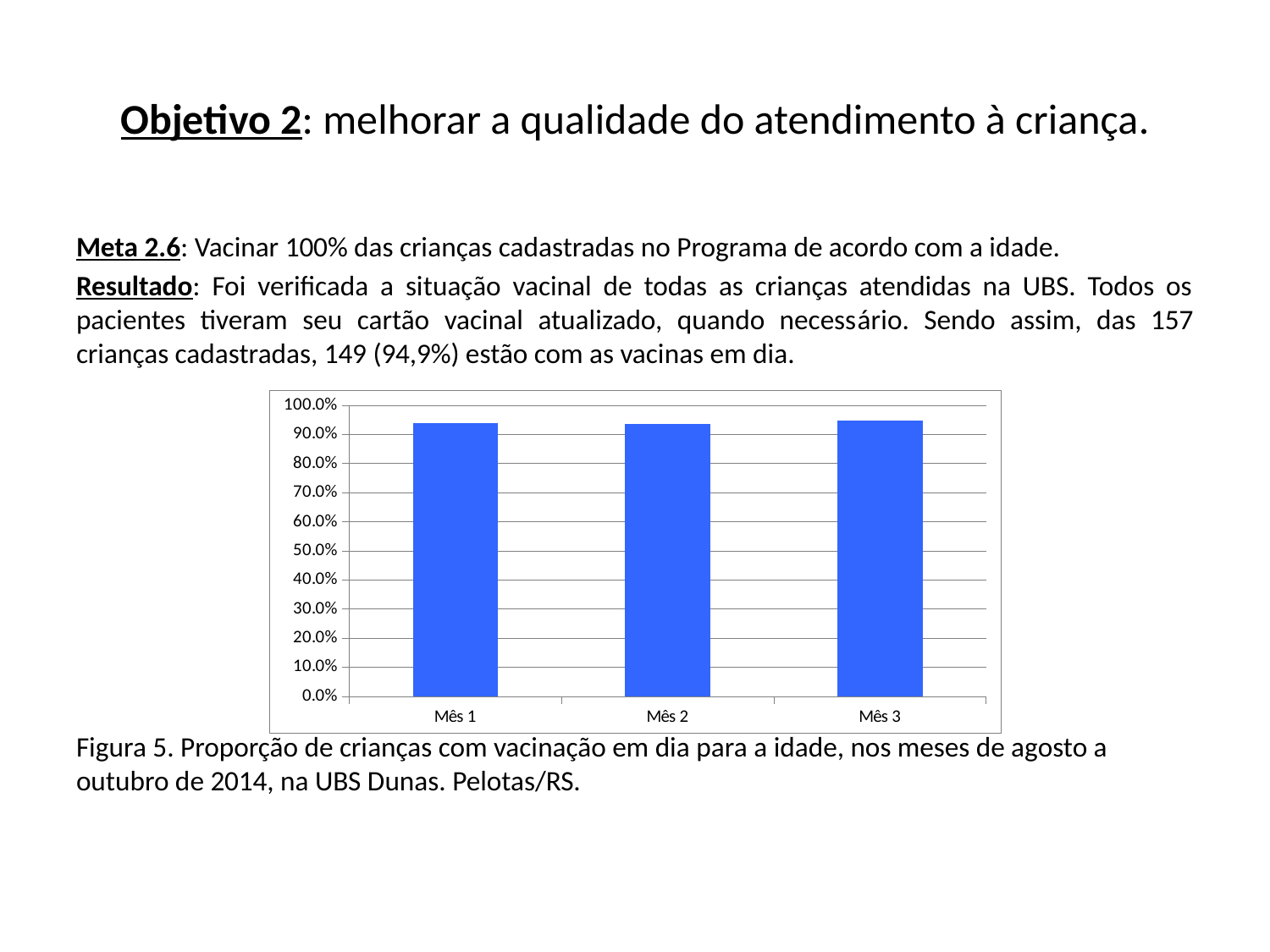
Is the value for Mês 3 greater or less than 90.0%? greater Is the value for Mês 2 greater or less than 90.0%? greater How many categories (months) are plotted on the chart? 3 Is the value for Mês 2 greater or less than 50.0%? greater What is the label of the first category on the x axis? Mês 1 What kind of chart is shown on the slide? bar chart What is the highest value shown on the y axis of the chart? 100.0%